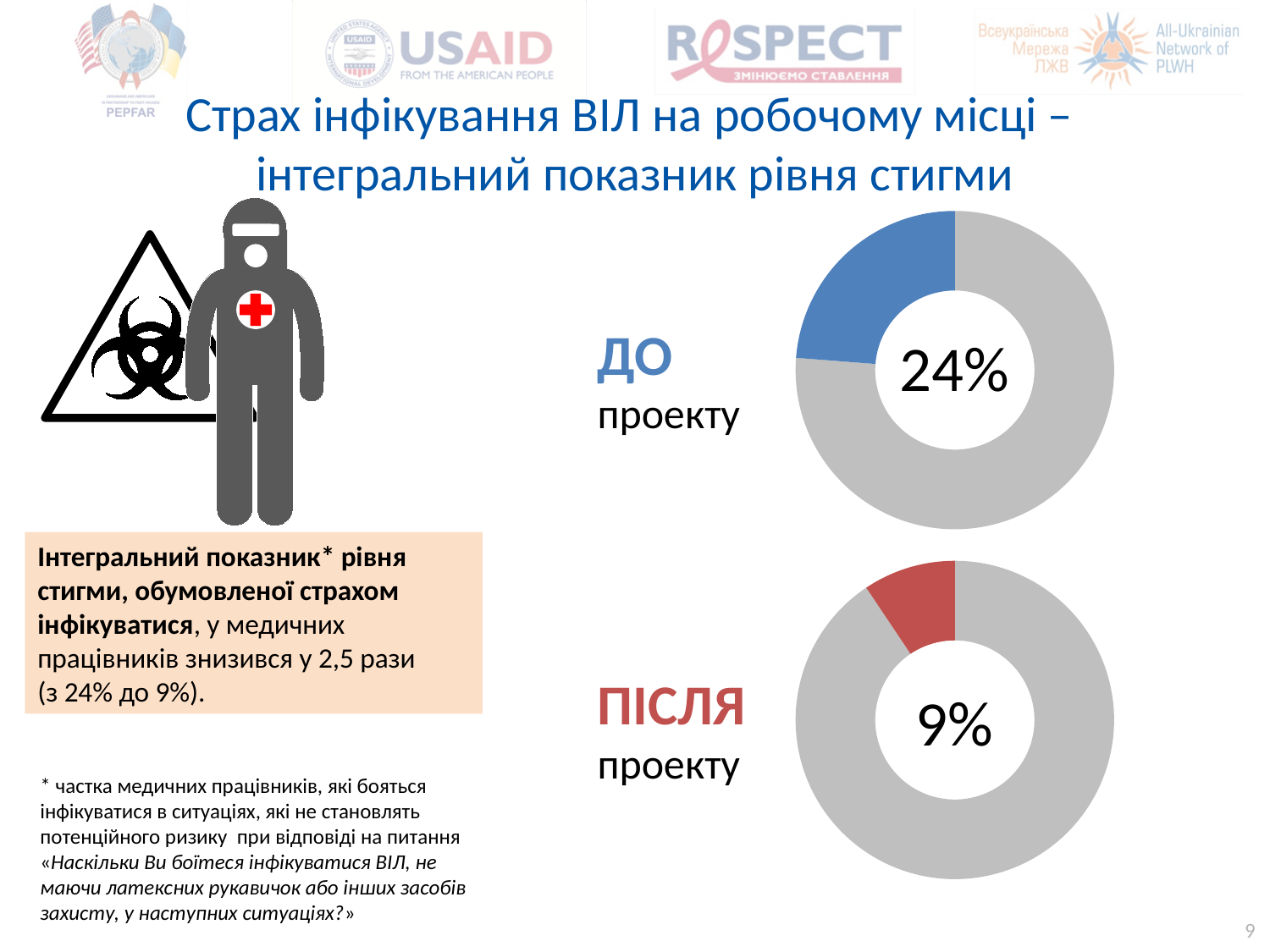
In the bottom donut chart labelled 'ПІСЛЯ проекту', what percentage is shown in the centre? 9% In the top donut chart labelled 'ДО проекту', what percentage is shown in the centre? 24% What kind of charts are shown on the right side of the slide? Donut (pie) charts Which of the two donut charts shows the lowest value? ПІСЛЯ проекту What colour is the highlighted slice in the 'ДО проекту' donut chart? Blue In the 'ДО проекту' donut chart, what share of the ring does the coloured slice represent? 24% What colour is the highlighted slice in the 'ПІСЛЯ проекту' donut chart? Red How many donut charts are on the slide? 2 Which chart shows the larger value, 'ДО проекту' or 'ПІСЛЯ проекту'? ДО проекту In the 'ПІСЛЯ проекту' donut chart, what share of the ring does the coloured slice represent? 9% Did the indicator rise or fall from 'ДО проекту' to 'ПІСЛЯ проекту'? Fall What is the difference between the value in the 'ДО проекту' chart and the value in the 'ПІСЛЯ проекту' chart? 15 percentage points